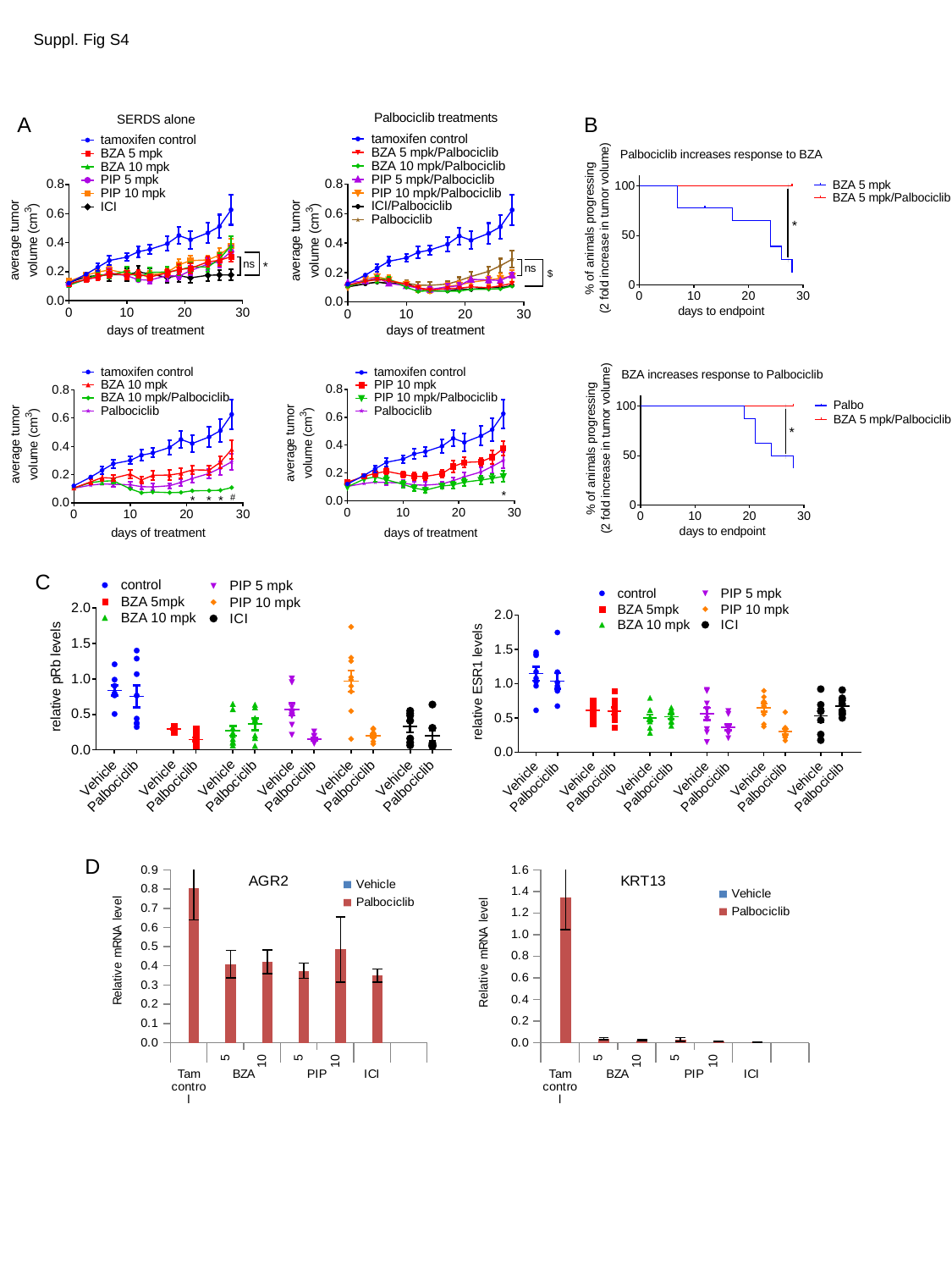
How many series does the legend of the 'SERDS alone' chart (panel A, top left) list? 6 In the 'SERDS alone' chart (panel A), does the tamoxifen control series rise or fall over the days of treatment? rise How many series does the legend of the 'Palbociclib treatments' chart (panel A, top right) list? 7 How many series does the legend of the 'BZA increases response to Palbociclib' chart (panel B, bottom) list? 2 In the KRT13 chart (panel D), which category has the highest bar? Tam control In the AGR2 chart (panel D), is the value for Tam control greater or less than 0.5? greater In the AGR2 chart (panel D), which category has the highest bar? Tam control What is the title of the top chart in panel B? Palbociclib increases response to BZA In the AGR2 chart (panel D), is the value for BZA 5 greater or less than 0.5? less What kind of chart is the AGR2 chart in panel D? bar chart In the KRT13 chart (panel D), is the value for Tam control greater or less than 1.0? greater